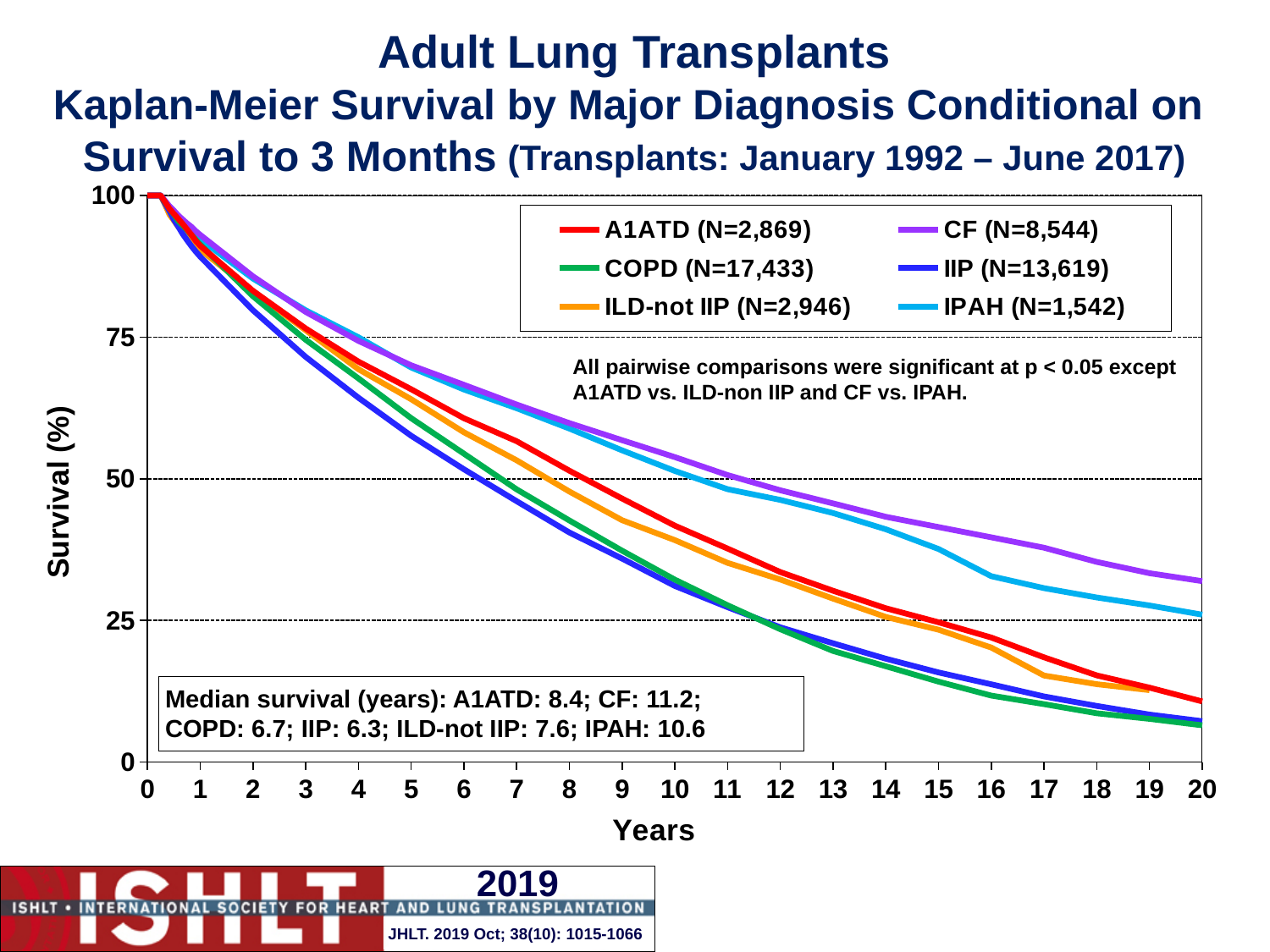
Which diagnosis has the lowest median survival listed in the text box? IIP Which diagnosis has the highest median survival listed in the text box? CF Is the survival for CF at 20 years greater or less than 25? greater Which curve shows higher survival at 20 years, CF or IPAH? CF Is the survival for COPD at 20 years greater or less than 25? less According to the text box, what is the median survival in years for CF? 11.2 According to the text box, what is the median survival in years for IIP? 6.3 What is the N shown in the legend for COPD? N=17,433 What is the difference in median survival (years) between CF and IIP? 4.9 What kind of chart is shown on the slide? line chart How many series does the legend list? 6 Do the survival curves rise or fall as years increase? fall